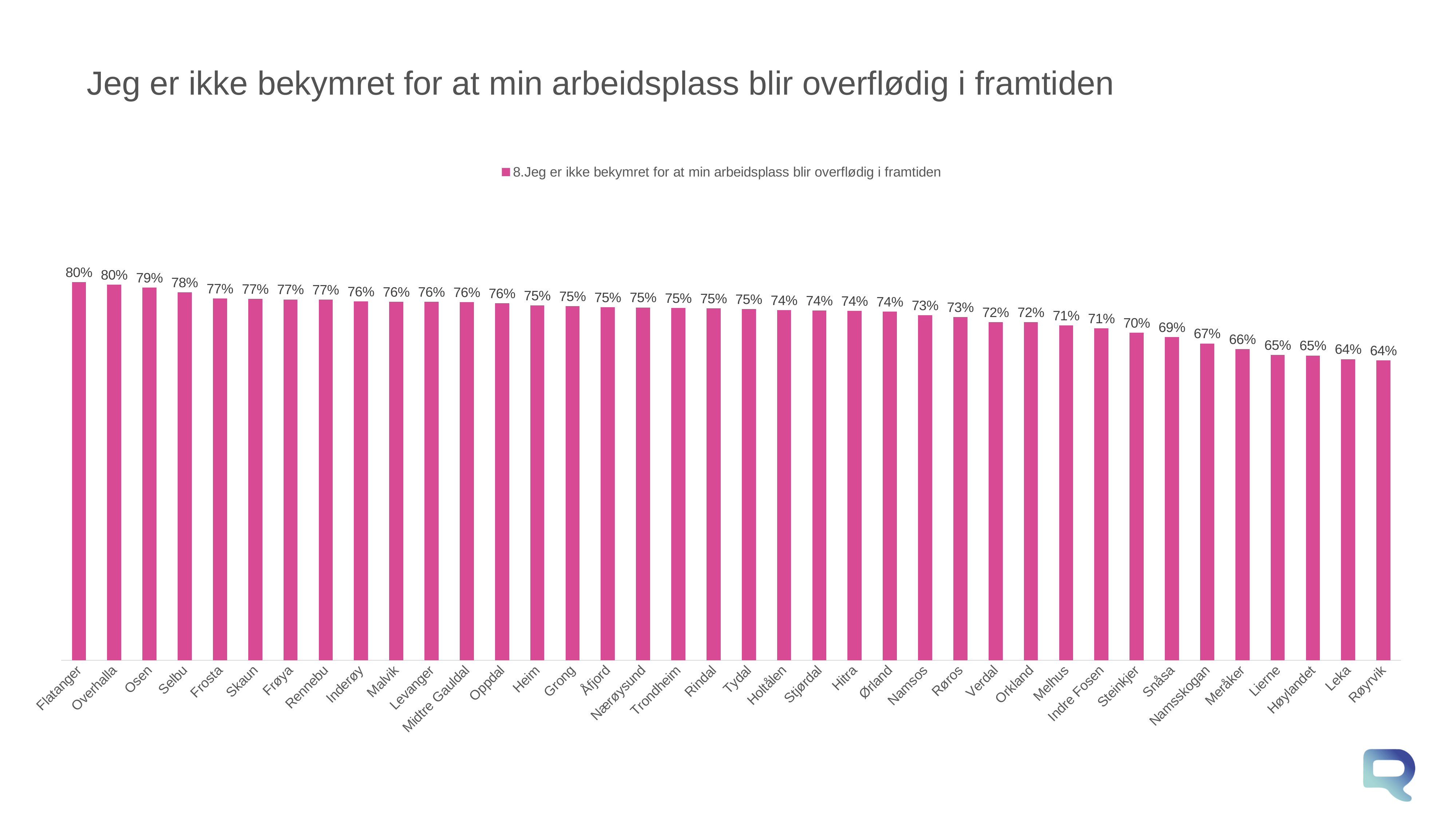
How many series does the legend list? 1 What is the difference between the values for Osen and Røyrvik? 15% What kind of chart is shown on the slide? Bar chart How many municipalities are shown in the chart? 38 Do the values rise or fall from left to right along the x axis? Fall What is the value for Flatanger? 80% What is the highest value shown in the chart? 80% Which has a larger value, Selbu or Snåsa? Selbu What is the value for Steinkjer? 70% What is the lowest value shown in the chart? 64% What is the value for Trondheim? 75% What is the value for Namsskogan? 67%